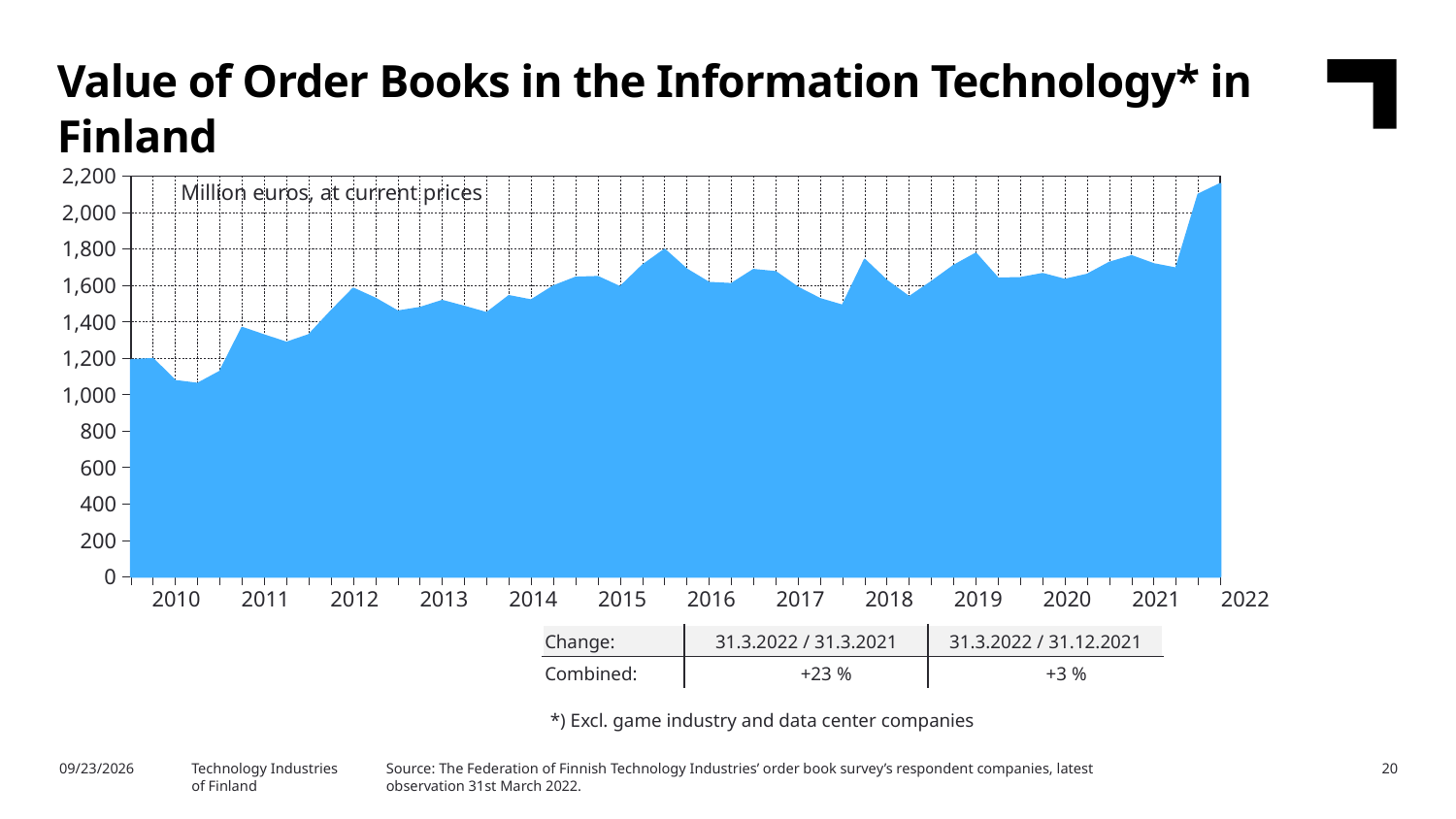
What unit is the chart's data measured in, according to the label inside the plot area? Million euros, at current prices In which year does the chart reach its lowest value? 2010 In which year does the chart reach its highest value? 2022 Which is larger: the value at the start of 2022 or the value at the start of 2010? 2022 What is the title of the chart on the slide? Value of Order Books in the Information Technology* in Finland What type of chart is shown on the slide? Area chart Is the value at the start of 2019 greater or less than 1,600? greater How many year labels are shown on the x axis of the chart? 13 Is the value at the start of 2012 greater or less than 1,400? greater Is the value at the end of the series in 2022 greater or less than 2,000? greater Overall, do the values rise or fall from 2010 to 2022? rise